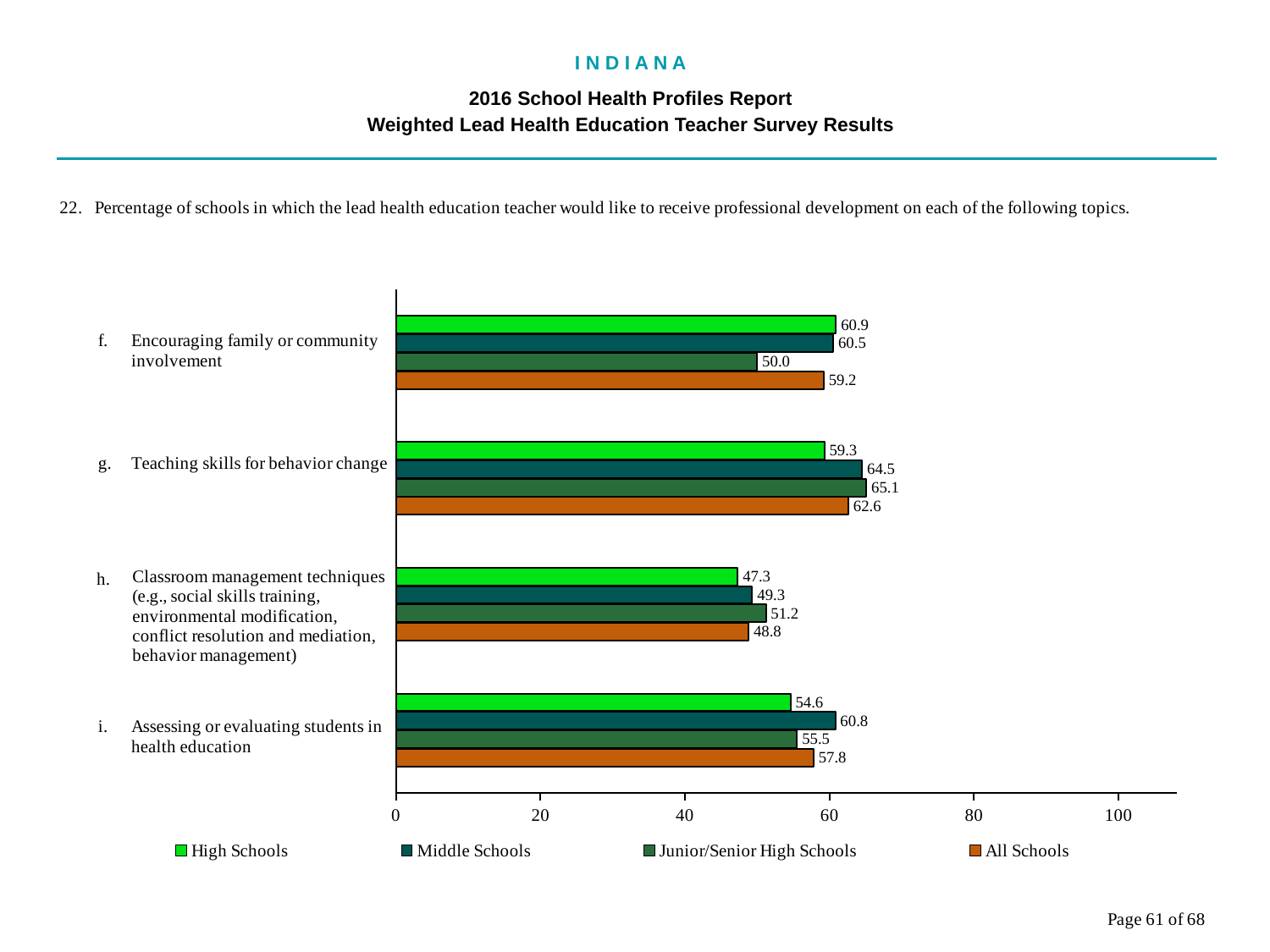
What is the value for High Schools for 'Encouraging family or community involvement'? 60.9 What kind of chart is shown on the slide? Bar chart How many topics (categories) are shown in the chart? 4 How many series does the legend list? 4 Which topic has the lowest value for High Schools? Classroom management techniques What colour represents All Schools in the legend? Orange What is the difference between the Middle Schools and Junior/Senior High Schools values for 'Encouraging family or community involvement'? 10.5 What is the value for Junior/Senior High Schools for 'Teaching skills for behavior change'? 65.1 What is the value for Middle Schools for 'Assessing or evaluating students in health education'? 60.8 Which is larger for 'Assessing or evaluating students in health education': the High Schools value or the Middle Schools value? Middle Schools Which topic has the highest value for All Schools? Teaching skills for behavior change What is the value for All Schools for 'Classroom management techniques'? 48.8